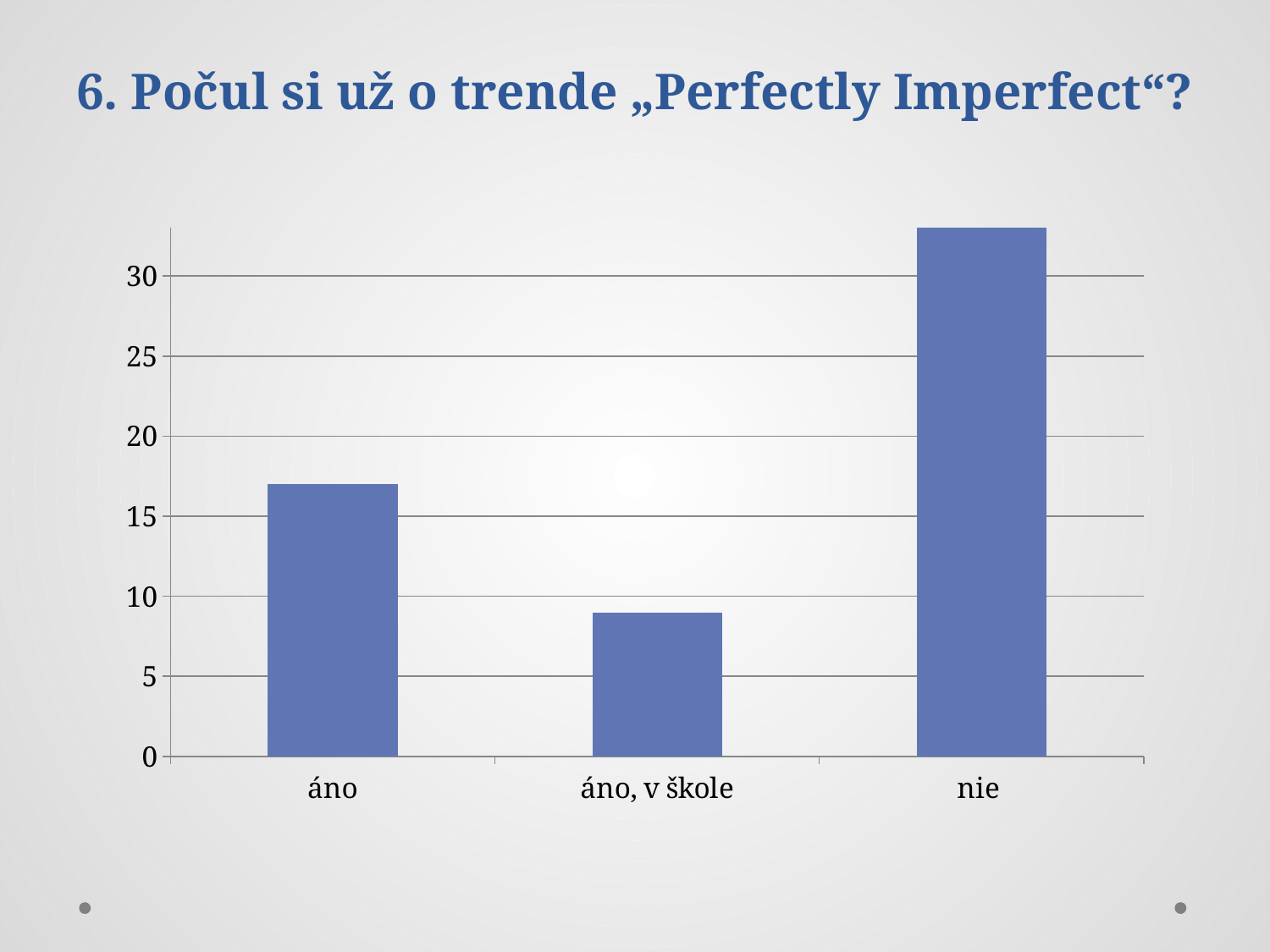
Is the value for "áno" greater or less than 15? greater What is the title of the slide containing the chart? 6. Počul si už o trende „Perfectly Imperfect“? What kind of chart is shown on the slide? bar chart Is the value for "nie" greater or less than 30? greater Which is larger, the value for "áno" or the value for "nie"? nie Which category has the lowest bar? áno, v škole Is the value for "áno, v škole" greater or less than 10? less Which category has the highest bar? nie How many categories are shown on the x axis of the chart? 3 Which is larger, the value for "áno" or the value for "áno, v škole"? áno